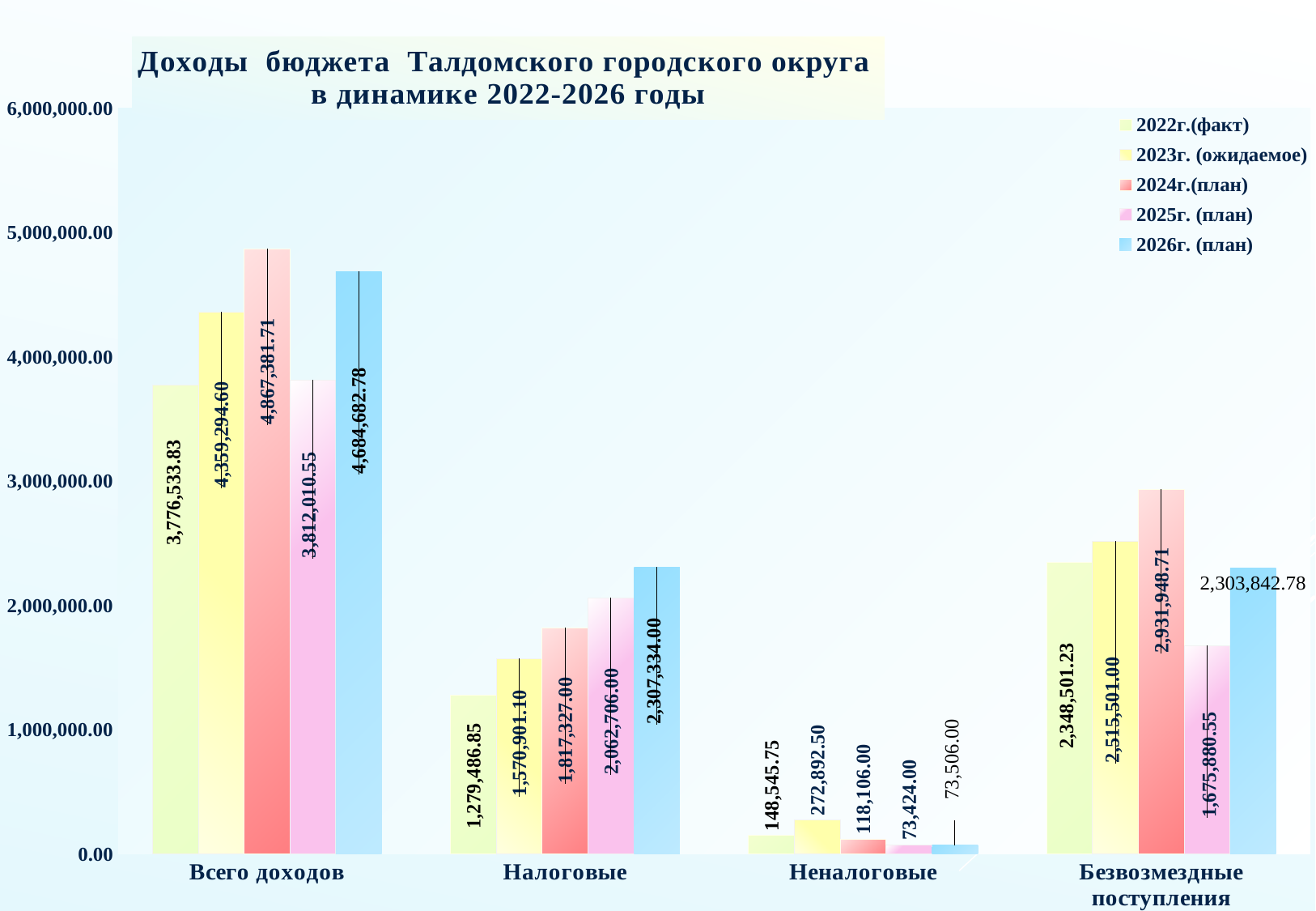
What is the value for 2023г. (ожидаемое) in the Неналоговые category? 272,892.50 What is the difference between the 2026г. (план) and 2022г.(факт) values in the Налоговые category? 1,027,847.15 Do the values in the Налоговые category rise or fall from 2022 to 2026? rise Is the value for 2024г.(план) in the Безвозмездные поступления category greater or less than 3,000,000.00? less How many categories are shown on the x axis? 4 What is the value for 2026г. (план) in the Налоговые category? 2,307,334.00 Which year has the lowest value in the Налоговые category? 2022г.(факт) How many series does the legend list? 5 What is the value for 2025г. (план) in the Безвозмездные поступления category? 1,675,880.55 What is the value for 2022г.(факт) in the Всего доходов category? 3,776,533.83 Which is larger in the Безвозмездные поступления category: the 2023г. (ожидаемое) value or the 2026г. (план) value? 2023г. (ожидаемое) Which year has the highest value in the Всего доходов category? 2024г.(план)